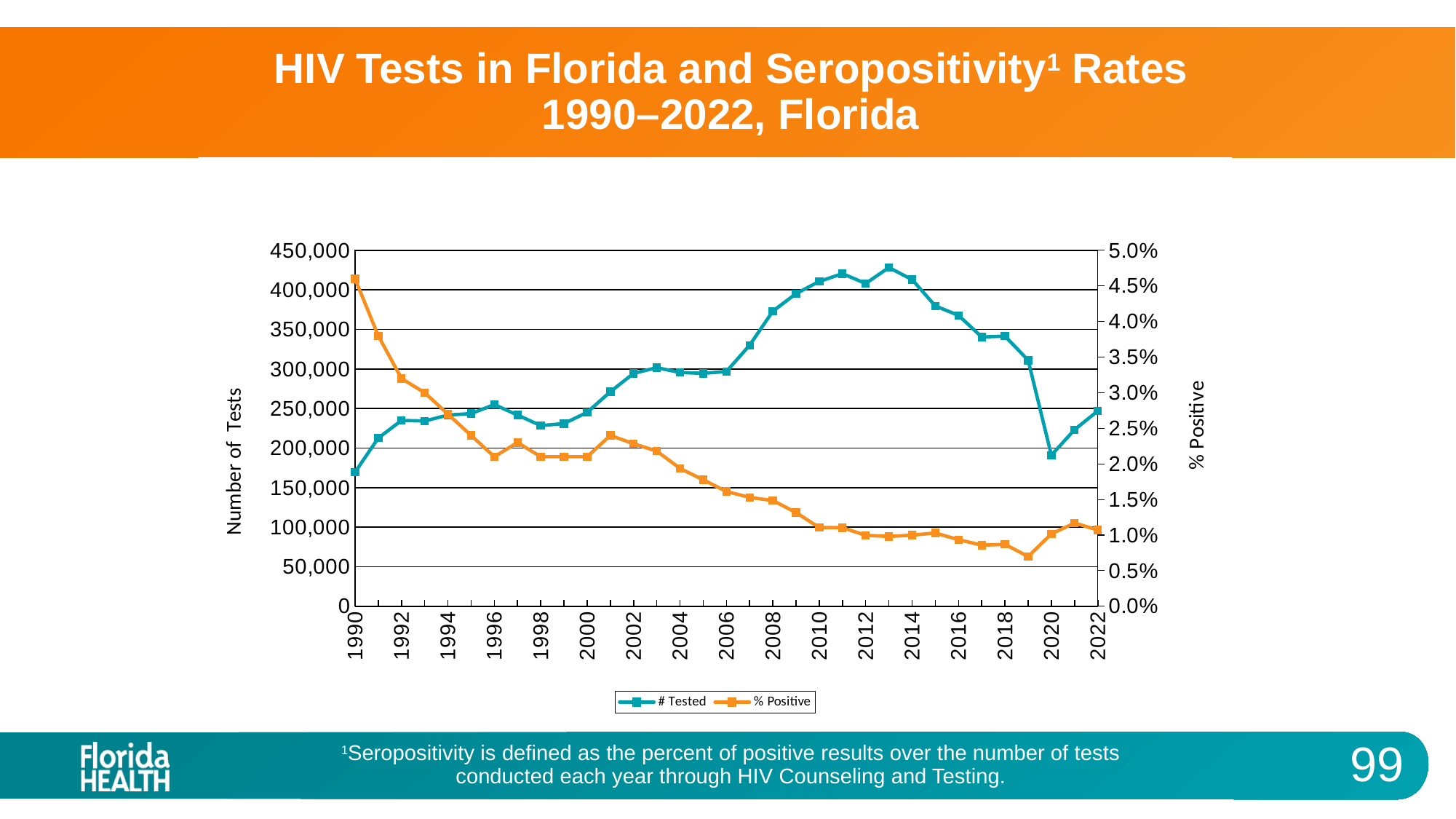
In which year is the % Positive series at its highest? 1990 Is the # Tested value for 2013 greater or less than 400,000? greater What are the two series named in the legend? # Tested and % Positive Is the # Tested value for 2020 greater or less than 200,000? less What is the title of the left vertical axis? Number of Tests In which year is the % Positive series at its lowest? 2019 Does the % Positive series generally rise or fall from 1990 to 2022? fall How many years are plotted along the x axis? 33 In which year is the # Tested series at its highest? 2013 Is the % Positive value for 1990 greater or less than 4.0%? greater What kind of chart is shown on the slide? line chart How many series does the legend list? 2